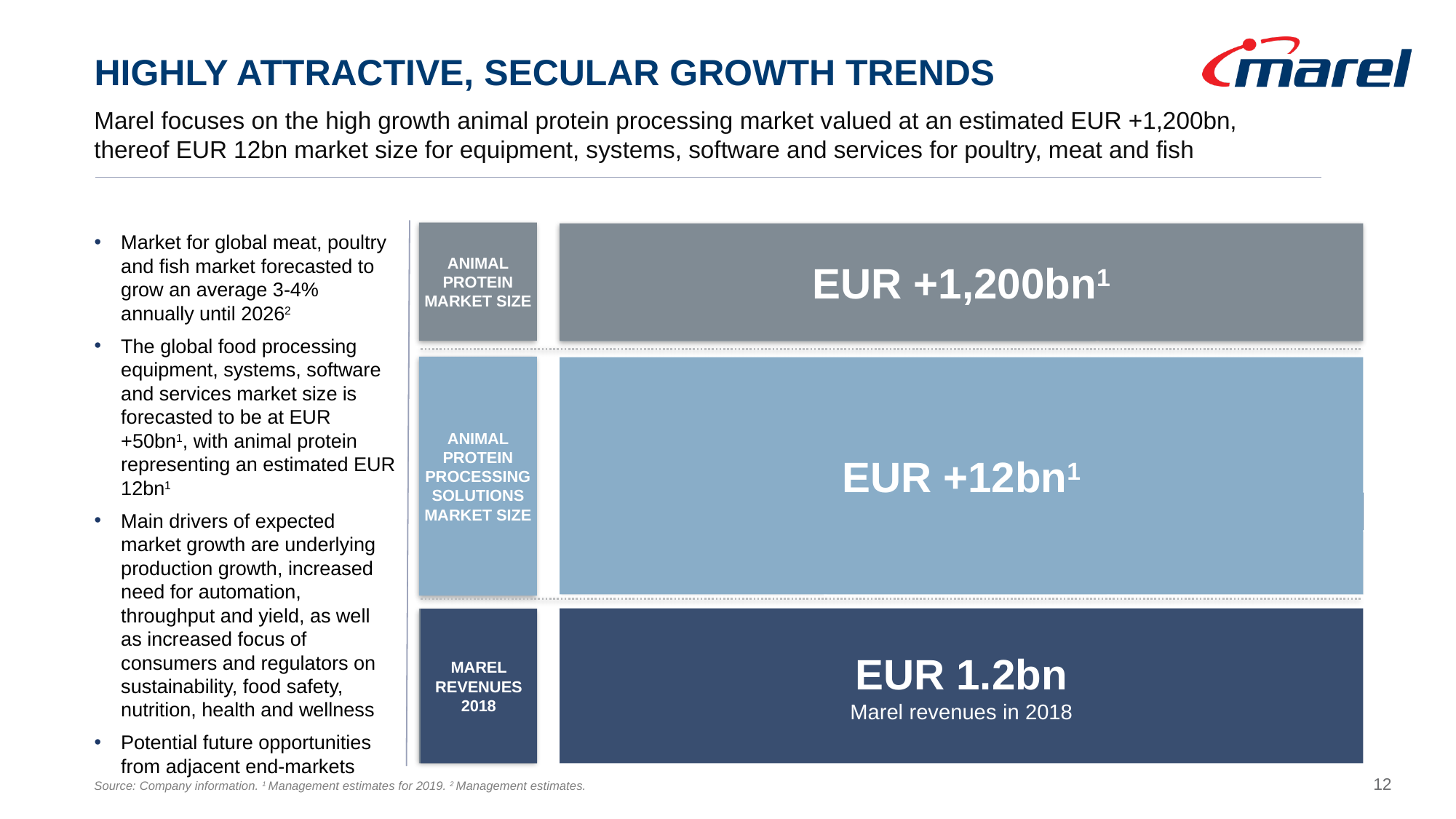
What value is shown for Marel Revenues 2018? EUR 1.2bn How many labelled blocks are shown in the graphic? 3 Which of the three blocks shows the smallest value? Marel Revenues 2018 Which block is shown at the bottom of the graphic? Marel Revenues 2018 What value is shown for Animal Protein Processing Solutions Market Size? EUR +12bn Which is larger: the Animal Protein Processing Solutions Market Size or Marel Revenues 2018? Animal Protein Processing Solutions Market Size Which of the three blocks shows the largest value? Animal Protein Market Size What value is shown for Animal Protein Market Size? EUR +1,200bn What year do the Marel revenues shown in the graphic refer to? 2018